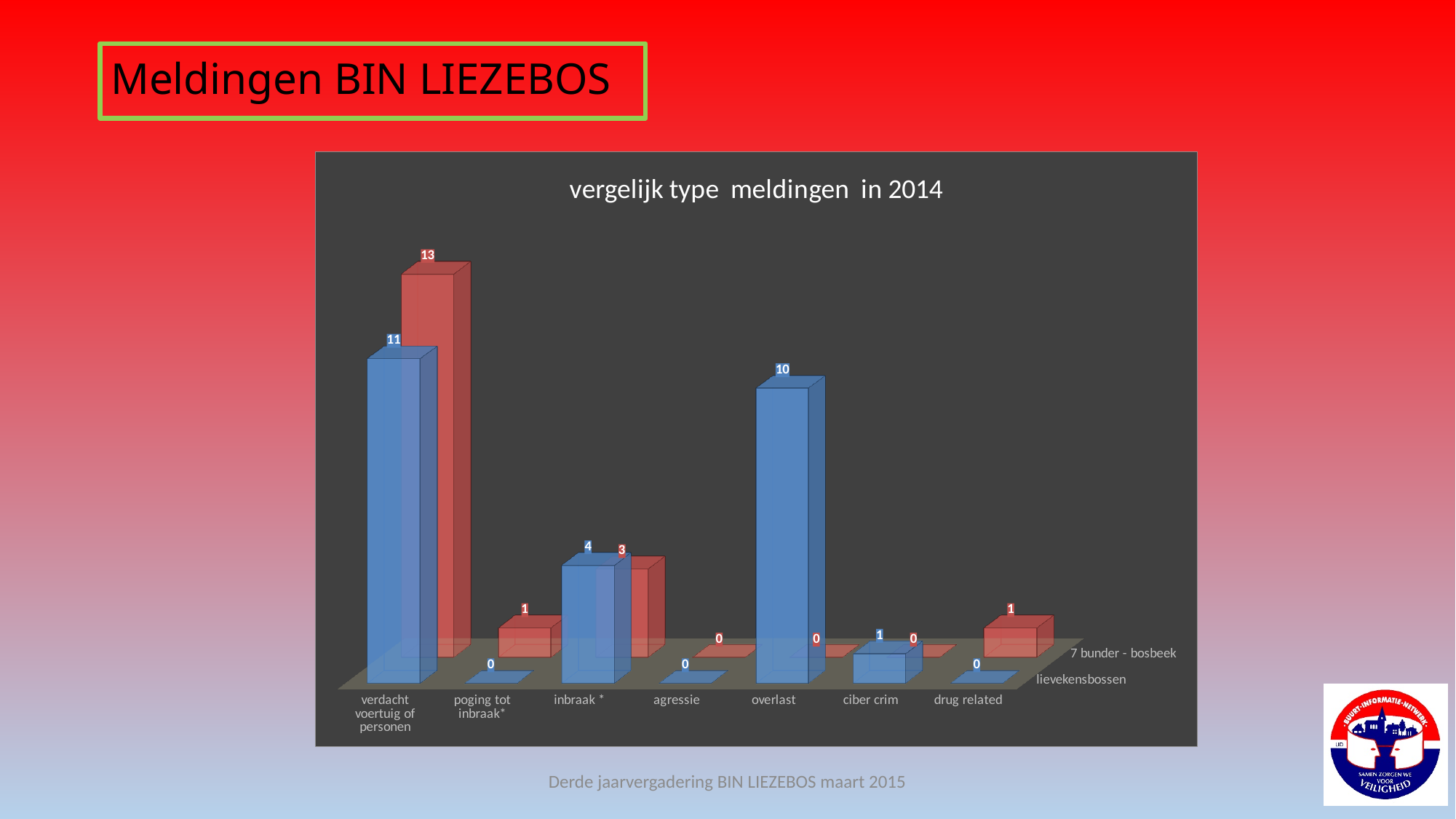
Which category has the highest value in the '7 bunder - bosbeek' series? verdacht voertuig of personen What kind of chart is shown on the slide? bar chart What is the value for 'inbraak *' in the '7 bunder - bosbeek' series? 3 What is the title of the chart? vergelijk type meldingen in 2014 What is the value for 'verdacht voertuig of personen' in the '7 bunder - bosbeek' series? 13 What is the value for 'agressie' in the 'lievekensbossen' series? 0 Which category has the highest value in the 'lievekensbossen' series? verdacht voertuig of personen For 'inbraak *', which series has the larger value, 'lievekensbossen' or '7 bunder - bosbeek'? lievekensbossen How many categories are shown along the x axis of the chart? 7 How many data series are plotted in the chart? 2 What is the value for 'overlast' in the 'lievekensbossen' series? 10 What is the difference between the '7 bunder - bosbeek' and 'lievekensbossen' values for 'verdacht voertuig of personen'? 2